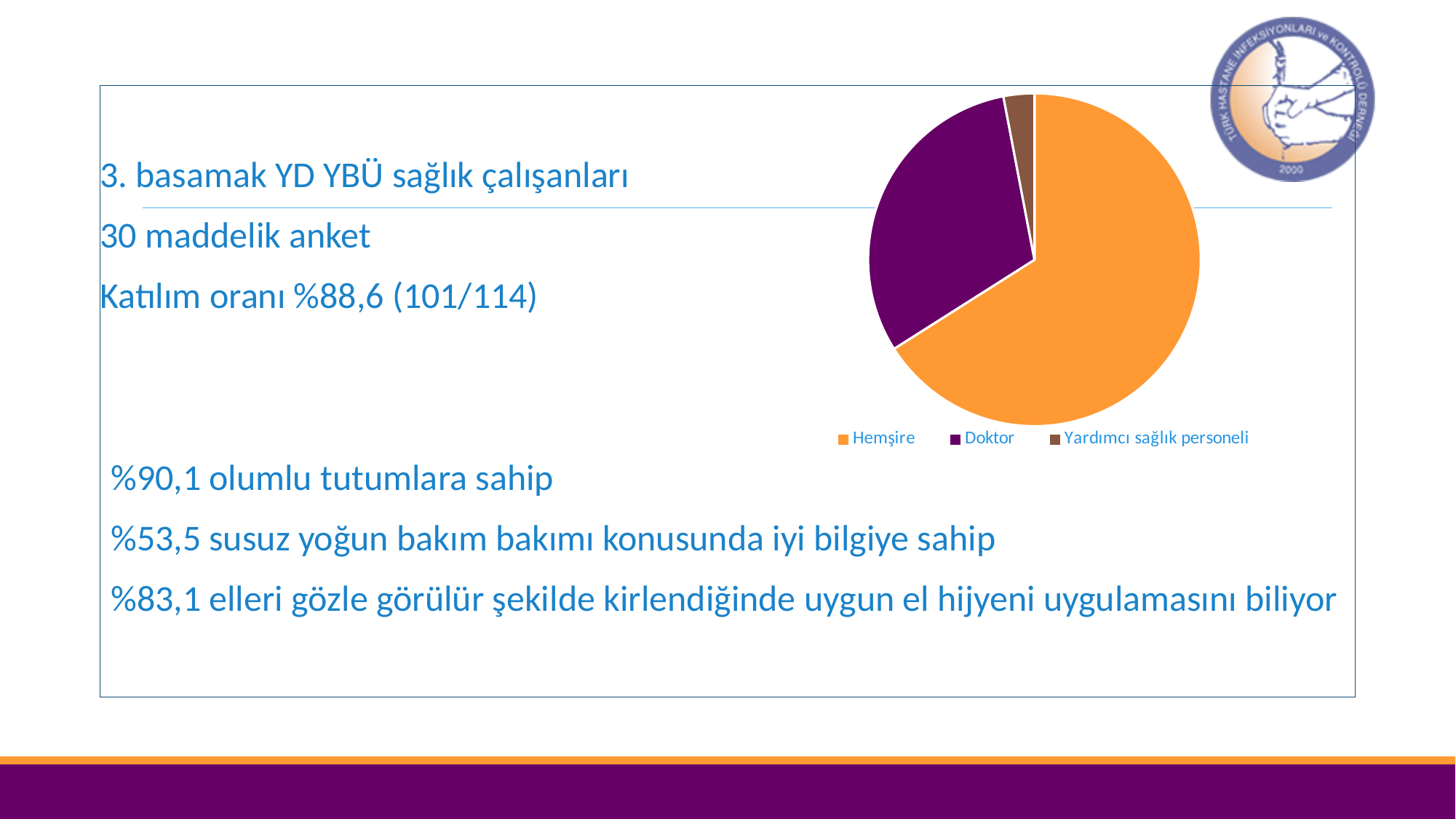
Which category is shown in orange in the pie chart? Hemşire Which category has the smallest slice in the pie chart? Yardımcı sağlık personeli Which category has the largest slice in the pie chart? Hemşire How many slices does the pie chart have? 3 What kind of chart is shown on the slide? pie chart What colour is the Doktor slice in the pie chart? purple Which slice is larger in the pie chart, Doktor or Yardımcı sağlık personeli? Doktor How many entries does the legend of the pie chart list? 3 Which slice is larger in the pie chart, Hemşire or Doktor? Hemşire